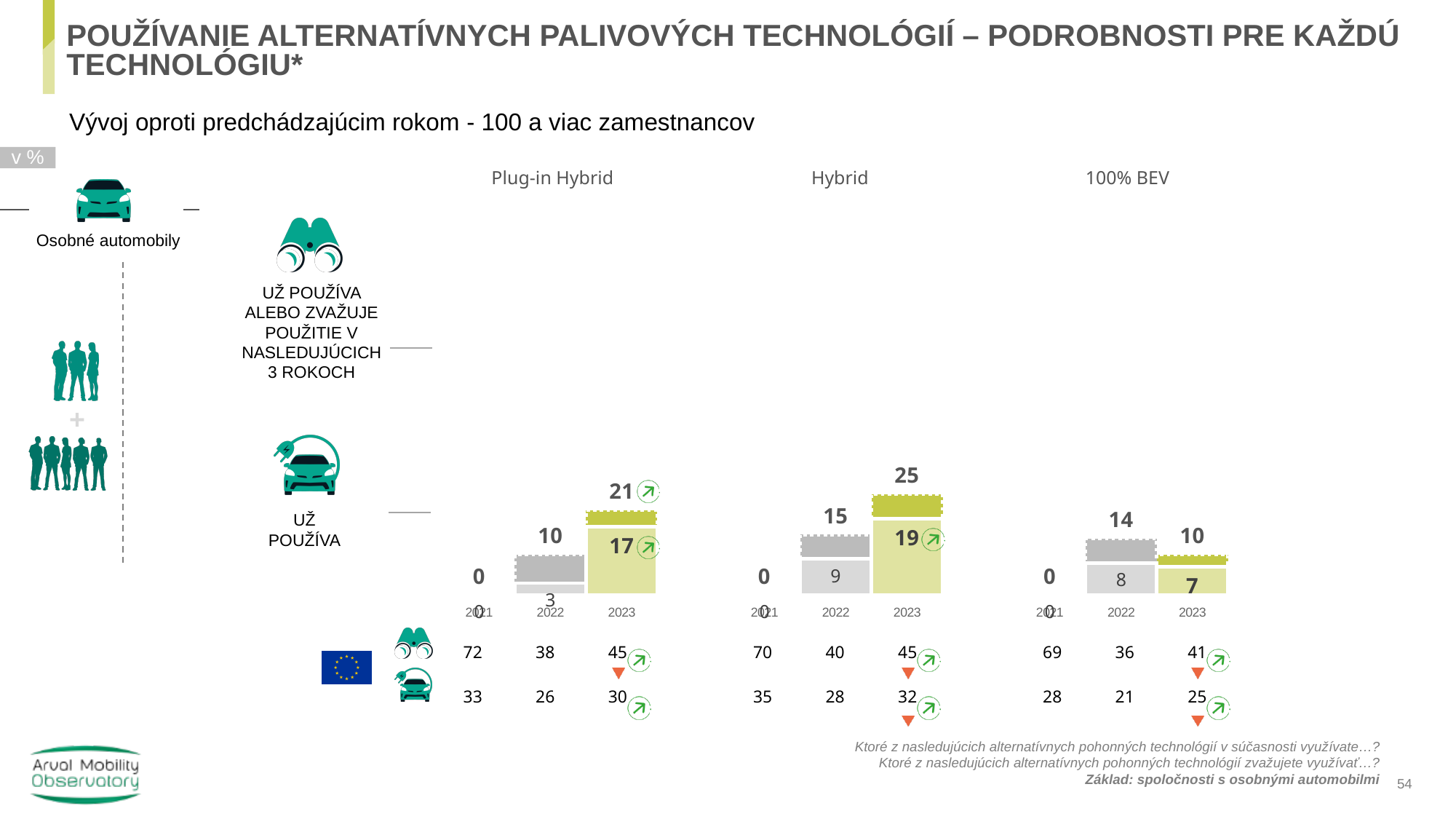
In the Plug-in Hybrid chart, what is the value for 'Už používa' in 2023? 17 In the 100% BEV chart, is the 'Už používa alebo zvažuje' value for 2022 larger or smaller than for 2023? larger In the Hybrid chart, what is the difference between the 'Už používa' values for 2023 and 2022? 10 How many alternative fuel technologies are shown as separate charts on the slide? 3 In the Plug-in Hybrid chart, does the 'Už používa' value rise or fall from 2021 to 2023? rise In the Hybrid chart, which year has the highest value for 'Už používa alebo zvažuje použitie v nasledujúcich 3 rokoch'? 2023 In the 100% BEV chart, what is the value for 'Už používa alebo zvažuje použitie v nasledujúcich 3 rokoch' in 2022? 14 What type of chart is used for the Hybrid data? bar chart In the Plug-in Hybrid chart, how many years are shown on the x axis? 3 In the Plug-in Hybrid chart, what is the value for 'Už používa alebo zvažuje použitie v nasledujúcich 3 rokoch' in 2023? 21 In the Hybrid chart, what is the value for 'Už používa' in 2022? 9 In the 100% BEV chart, which year has the lowest value for 'Už používa'? 2021